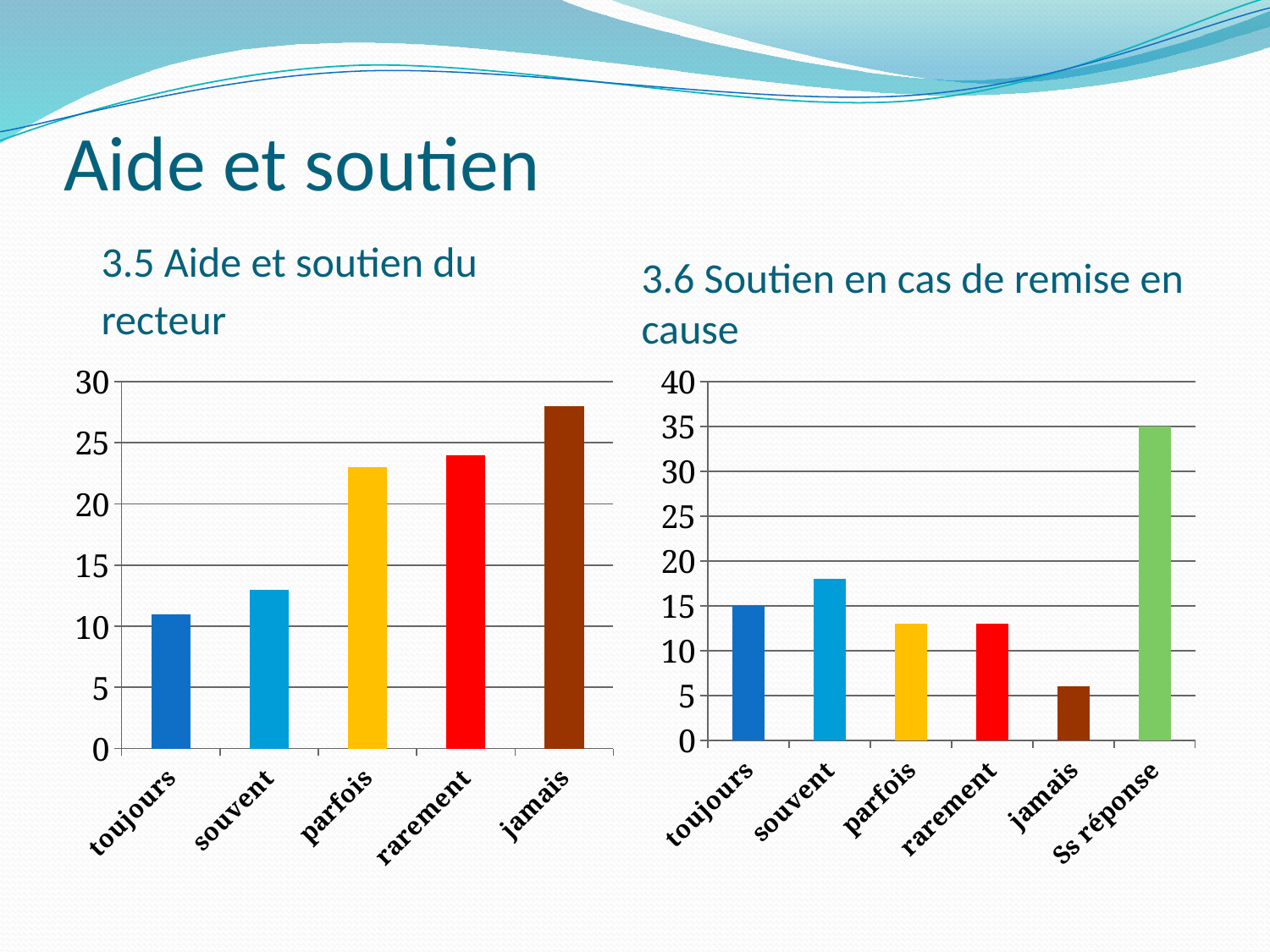
How many categories are shown on the right chart, '3.6 Soutien en cas de remise en cause'? 6 On the left chart, '3.5 Aide et soutien du recteur', is the value for toujours greater or less than 15? less On the left chart, '3.5 Aide et soutien du recteur', do the values generally rise or fall from toujours to jamais? rise On the left chart, '3.5 Aide et soutien du recteur', which category has the highest value? jamais On the right chart, '3.6 Soutien en cas de remise en cause', which category has the lowest value? jamais What kind of chart is the left chart, '3.5 Aide et soutien du recteur'? bar chart On the right chart, '3.6 Soutien en cas de remise en cause', is the value for jamais greater or less than 10? less On the right chart, '3.6 Soutien en cas de remise en cause', which category has the highest value? Ss réponse On the left chart, '3.5 Aide et soutien du recteur', is the value for jamais greater or less than 25? greater How many categories are shown on the left chart, '3.5 Aide et soutien du recteur'? 5 On the right chart, '3.6 Soutien en cas de remise en cause', which is larger, the value for souvent or the value for toujours? souvent On the left chart, '3.5 Aide et soutien du recteur', which category has the lowest value? toujours